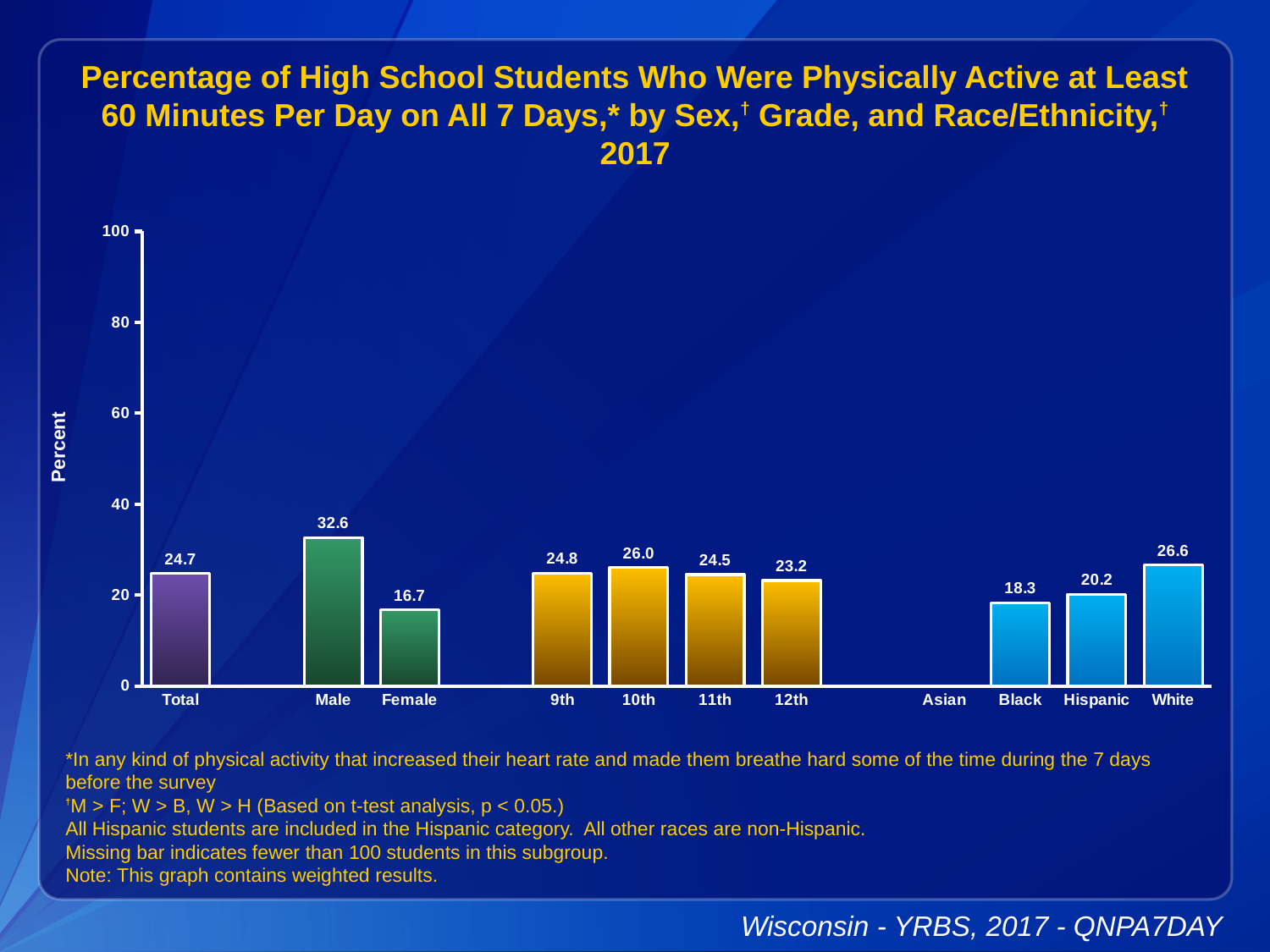
What is the value for Female? 16.7 What is the difference between the Male and Female values? 15.9 What is the value for Male? 32.6 What is the value for 10th grade? 26.0 Which category has the highest value? Male What is the value for Hispanic? 20.2 Which category has no bar shown? Asian What is the label on the y axis? Percent Which category with a bar has the lowest value? Female Is the value for Total greater or less than 20? greater Which is larger, the value for White or the value for Black? White What kind of chart is shown? bar chart